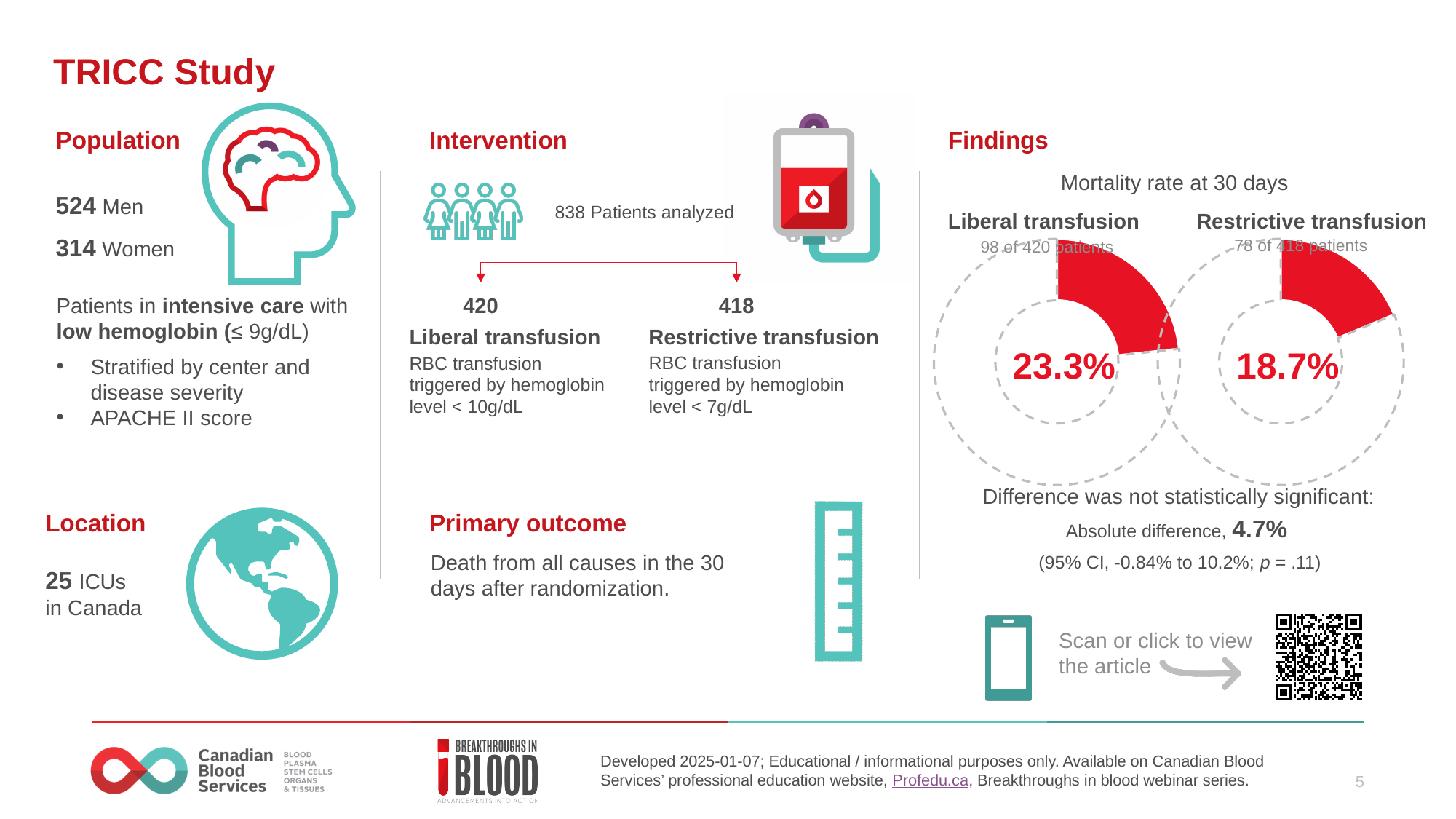
What kind of chart is used to show the mortality rates in the Findings section? doughnut chart In the Findings charts, how many patients died in the Liberal transfusion group, as labelled above the chart? 98 of 420 patients What colour is the filled slice in the Findings mortality-rate charts? red In the Findings charts, what is the 30-day mortality rate shown for the Restrictive transfusion group? 18.7% In the Findings charts, which transfusion group has the lower 30-day mortality rate? Restrictive transfusion In the Findings charts, is the mortality rate for Liberal transfusion larger or smaller than that for Restrictive transfusion? larger How many mortality-rate charts are shown in the Findings section? 2 In the Findings charts, how many patients died in the Restrictive transfusion group, as labelled above the chart? 78 of 418 patients In the Findings charts, which transfusion group has the higher 30-day mortality rate? Liberal transfusion In the Findings charts, what is the 30-day mortality rate shown for the Liberal transfusion group? 23.3% What absolute difference in mortality rate is printed below the Findings charts? 4.7% What heading appears above the two mortality-rate charts in the Findings section? Mortality rate at 30 days